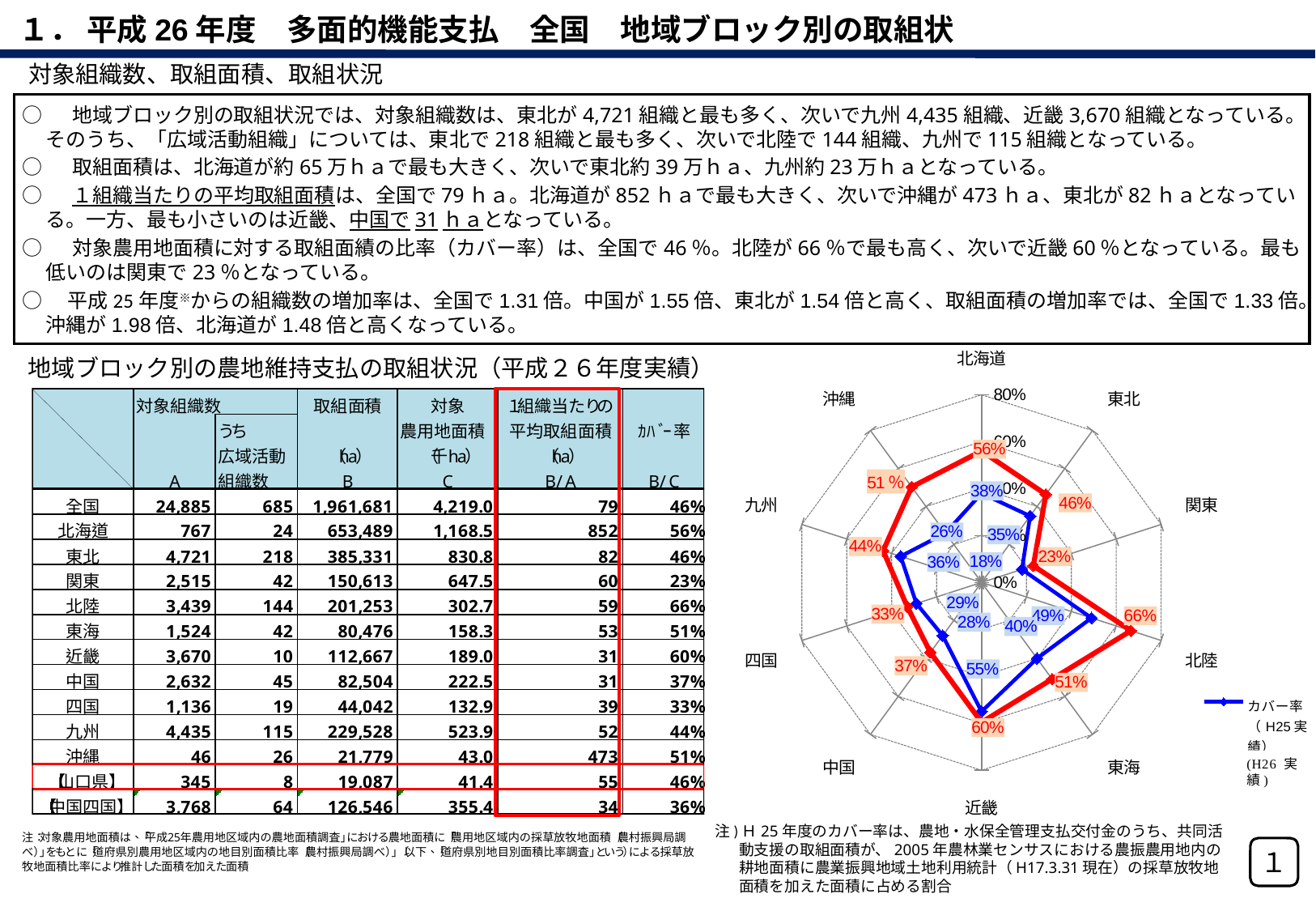
In the radar chart, what is the H26 カバー率 for 関東? 23% In the radar chart, what is the H26 カバー率 for 近畿? 60% In the radar chart, which region has the highest H26 カバー率? 北陸 In the radar chart, what is the H26 カバー率 for 北陸? 66% In the radar chart, what is the difference between the H26 カバー率 of 北陸 and 関東? 43 percentage points What kind of chart is shown on the right side of the slide? Radar chart How many series does the radar chart's legend list? 2 In the radar chart, which region has the lowest H26 カバー率? 関東 In the radar chart, which has the larger H26 カバー率, 北海道 or 中国? 北海道 In the radar chart, which colour is used for the H26 実績 series? Red In the radar chart, what is the H25 カバー率 for 近畿? 55% How many regions (axes) does the radar chart have? 10